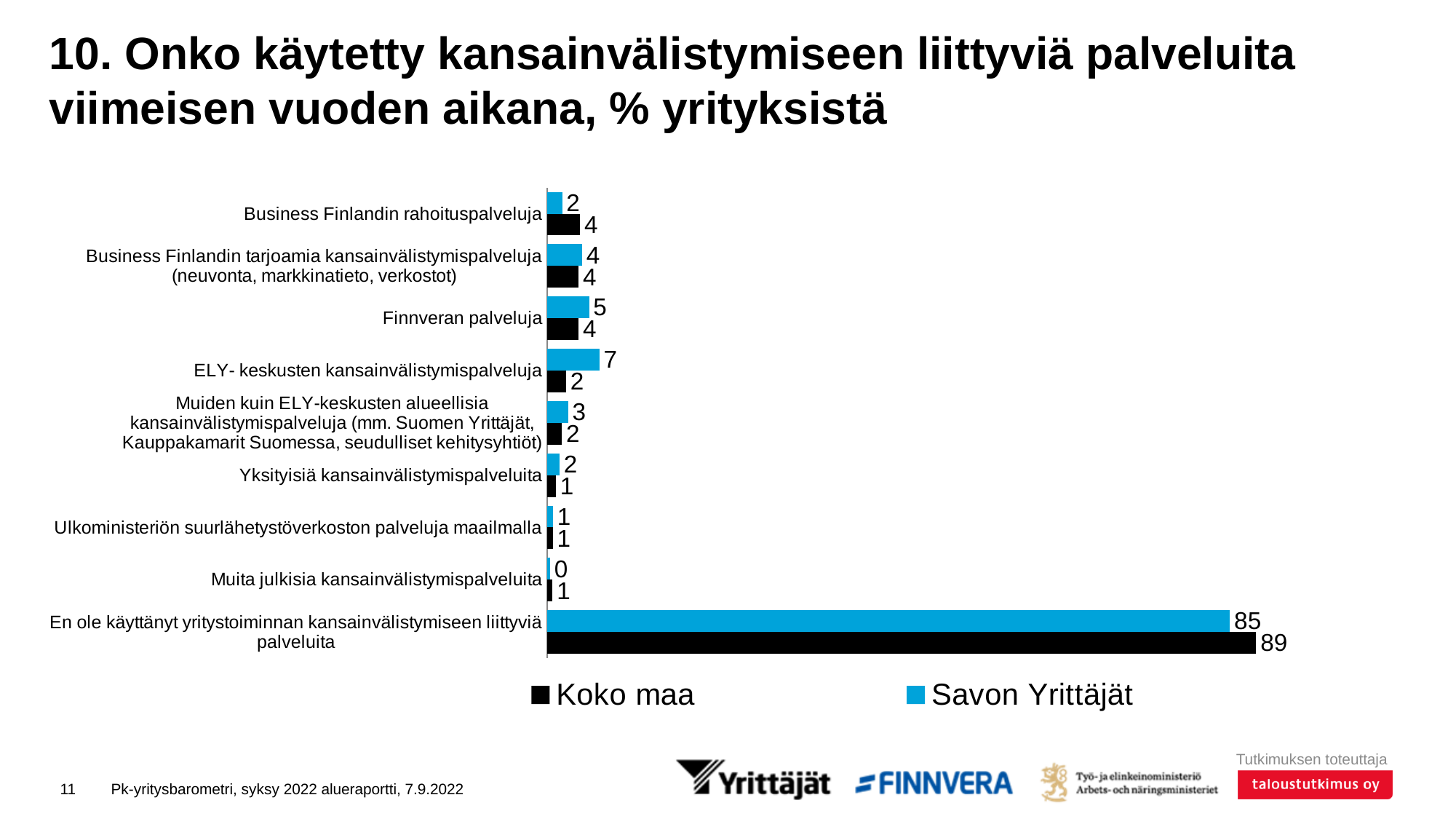
Which category has the highest value for Savon Yrittäjät? En ole käyttänyt yritystoiminnan kansainvälistymiseen liittyviä palveluita What kind of chart is shown on the slide? Bar chart What is the value for Koko maa for 'Business Finlandin rahoituspalveluja'? 4 For 'ELY- keskusten kansainvälistymispalveluja', which series has the larger value, Koko maa or Savon Yrittäjät? Savon Yrittäjät What is the value for Savon Yrittäjät for 'ELY- keskusten kansainvälistymispalveluja'? 7 How many categories are shown on the chart? 9 What is the value for Koko maa for 'En ole käyttänyt yritystoiminnan kansainvälistymiseen liittyviä palveluita'? 89 How many series does the legend list? 2 What is the value for Savon Yrittäjät for 'Finnveran palveluja'? 5 Which colour represents the Savon Yrittäjät series? Blue What is the difference between the Koko maa and Savon Yrittäjät values for 'En ole käyttänyt yritystoiminnan kansainvälistymiseen liittyviä palveluita'? 4 Which category has the lowest value for Savon Yrittäjät? Muita julkisia kansainvälistymispalveluita